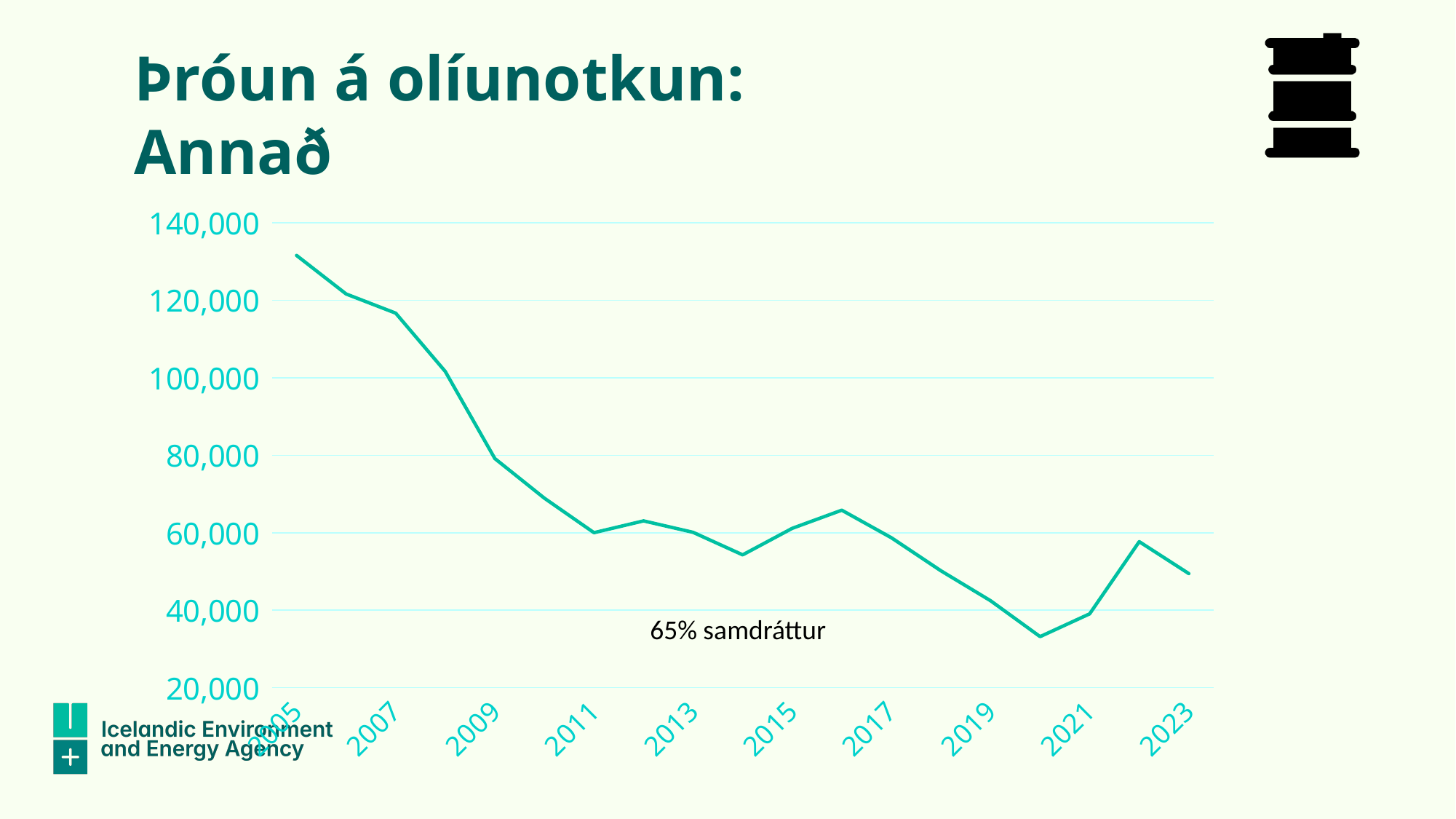
What kind of chart is shown on the slide? line chart Is the value for 2020 greater or less than 40,000? less Is the value for 2005 greater or less than 120,000? greater Which year has the highest value on the chart? 2005 Is the value for 2009 greater or less than 100,000? less Which year has the larger value, 2020 or 2022? 2022 Overall, do the values rise or fall from 2005 to 2023? fall What annotation text is printed on the chart? 65% samdráttur Which year has the lowest value on the chart? 2020 Which year has the larger value, 2005 or 2011? 2005